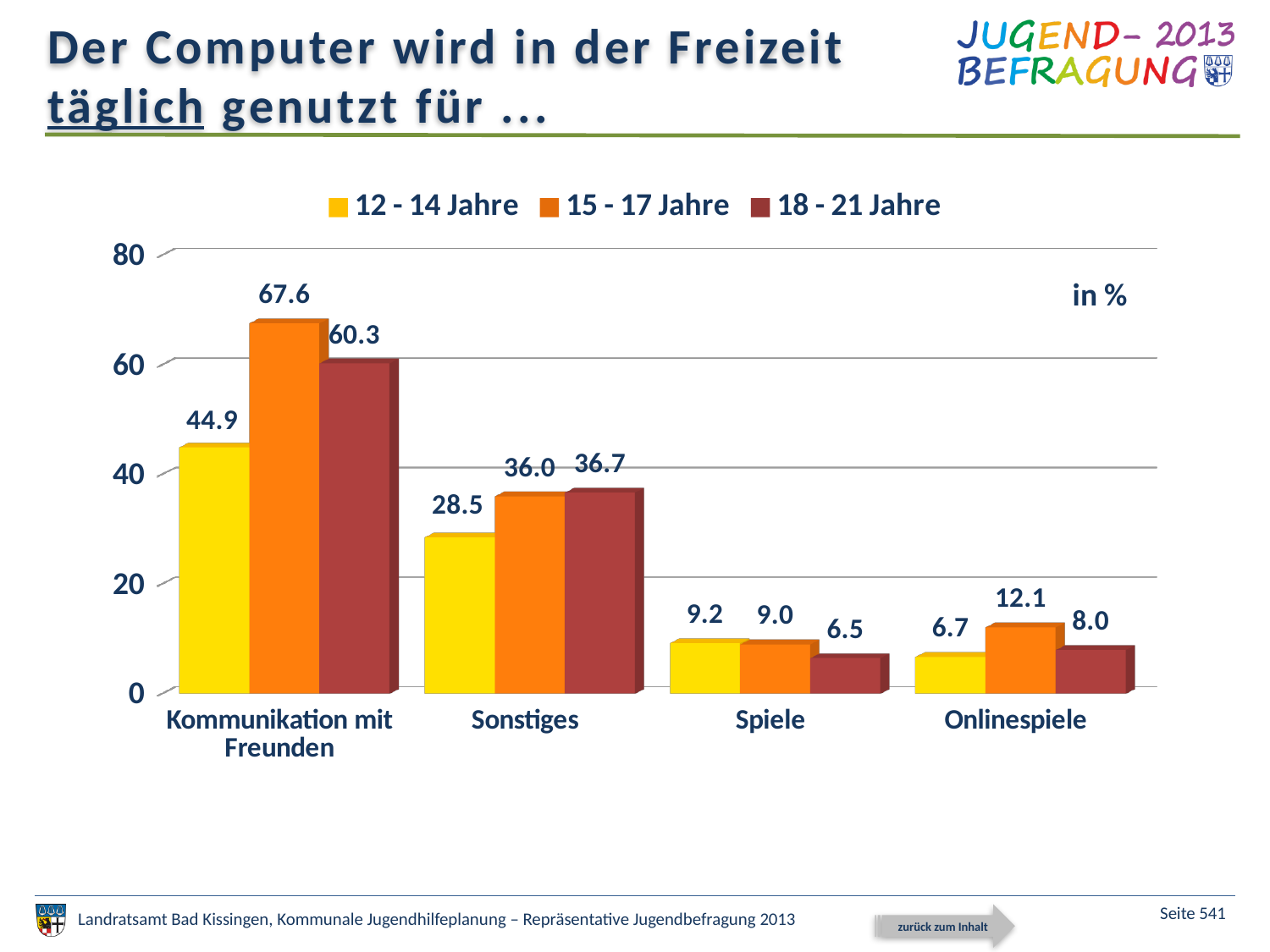
How many series does the legend list? 3 Is the value for 12 - 14 Jahre in the Kommunikation mit Freunden category greater or less than 40? greater What is the difference between the 15 - 17 Jahre and 18 - 21 Jahre values in the Kommunikation mit Freunden category? 7.3 Which category has the lowest value for the 18 - 21 Jahre series? Spiele What is the value for 18 - 21 Jahre in the Onlinespiele category? 8.0 What kind of chart is shown on the slide? bar chart What is the value for 15 - 17 Jahre in the Kommunikation mit Freunden category? 67.6 What is the value for 12 - 14 Jahre in the Sonstiges category? 28.5 How many categories are shown on the x axis? 4 Which is larger in the Onlinespiele category: the value for 12 - 14 Jahre or for 15 - 17 Jahre? 15 - 17 Jahre Which category has the highest value for the 12 - 14 Jahre series? Kommunikation mit Freunden What unit is indicated for the values in the chart? in %